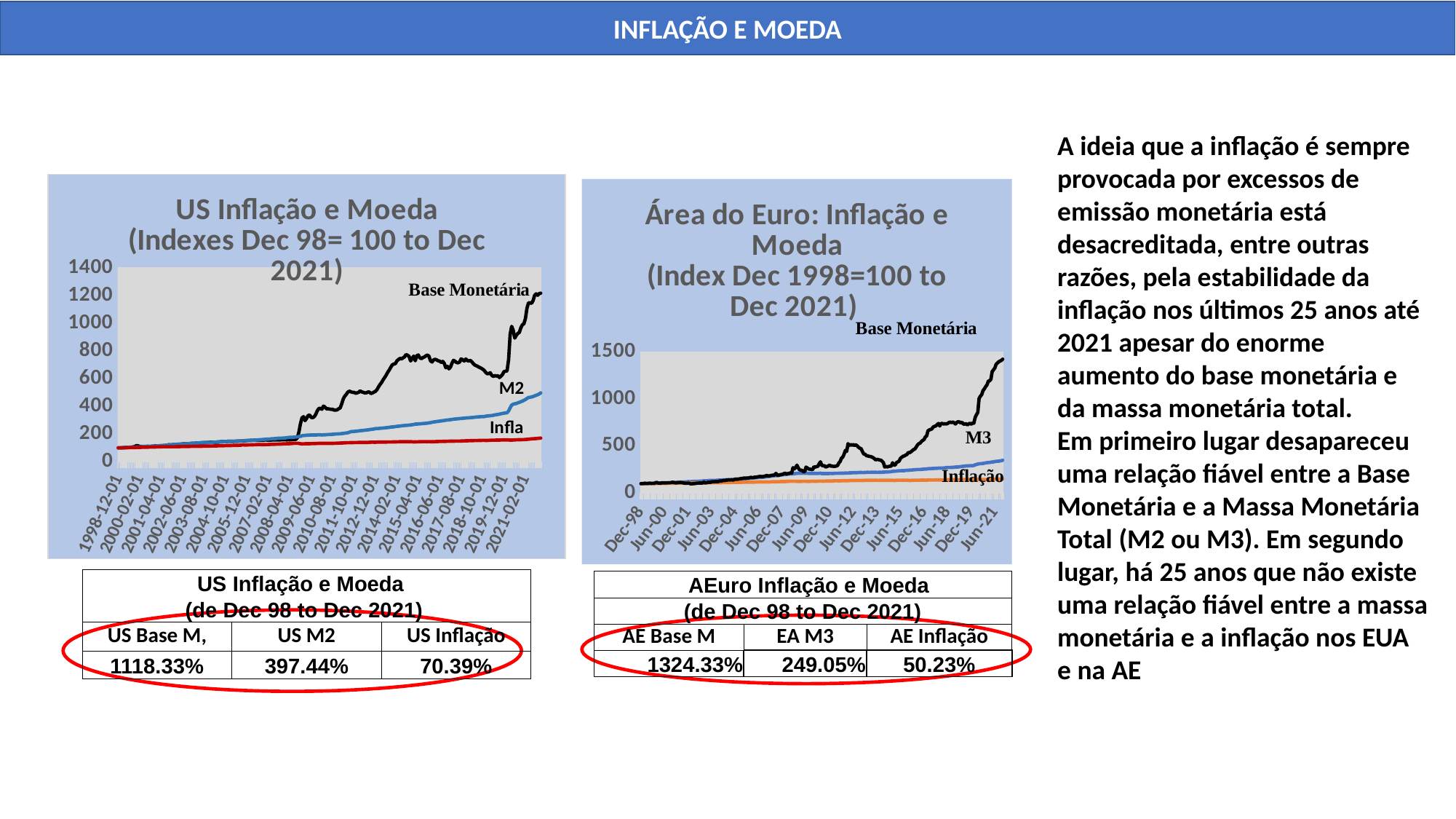
In the 'US Inflação e Moeda' chart, which series is highest at the end of the period? Base Monetária What colour is the Inflação line in the 'Área do Euro: Inflação e Moeda' chart? orange In the 'US Inflação e Moeda' chart, is the final value of Base Monetária greater or less than 1000? greater In the 'Área do Euro: Inflação e Moeda' chart, is the final value of Base Monetária greater or less than 1000? greater In the 'US Inflação e Moeda' chart, is the final value of M2 greater or less than 600? less In the 'Área do Euro: Inflação e Moeda' chart, which is larger at the end of the period, M3 or Inflação? M3 In the 'Área do Euro: Inflação e Moeda' chart, does the Base Monetária series generally rise or fall from Dec-98 to Jun-21? rise How many series are plotted in the 'Área do Euro: Inflação e Moeda' chart? 3 What kind of chart is the 'US Inflação e Moeda' chart on the left? line chart How many series are plotted in the 'US Inflação e Moeda' chart? 3 In the 'US Inflação e Moeda' chart, which series is lowest at the end of the period? Infla